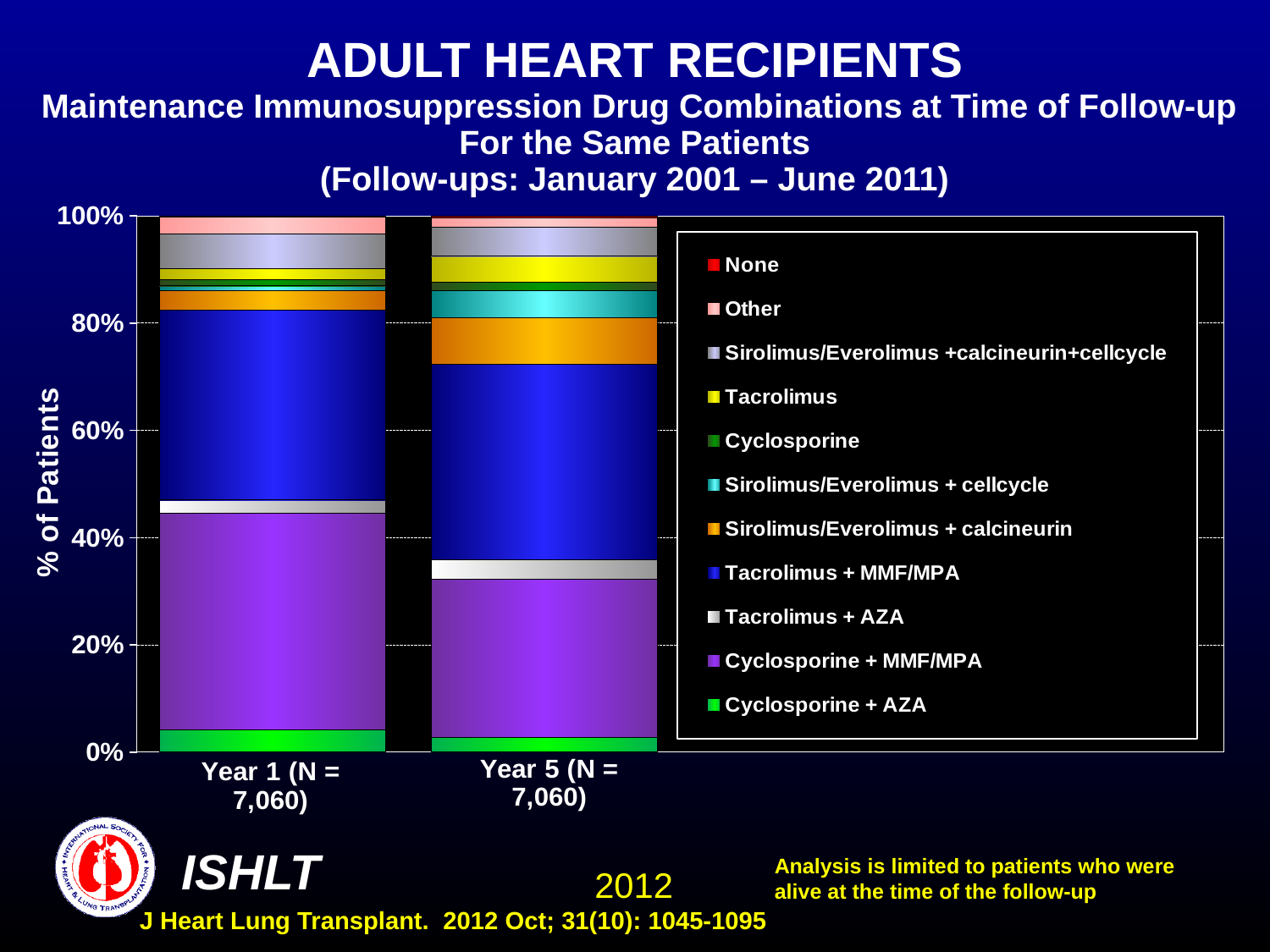
How many drug combination series does the legend list? 11 What is the label of the y axis? % of Patients How many bars (follow-up time points) are plotted in the chart? 2 Does the share of Tacrolimus alone rise or fall from Year 1 to Year 5? Rise What kind of chart is shown on the slide? Stacked bar chart Is the share of Tacrolimus + MMF/MPA in Year 1 greater or less than 20%? greater Which bar has the larger Sirolimus/Everolimus + calcineurin segment, Year 1 or Year 5? Year 5 What is the N shown for the Year 5 bar? 7,060 Which bar has the larger Cyclosporine + MMF/MPA segment, Year 1 or Year 5? Year 1 Is the share of Cyclosporine + MMF/MPA in Year 5 greater or less than 40%? less Does the share of Cyclosporine + MMF/MPA rise or fall from Year 1 to Year 5? Fall Which drug combination makes up the largest segment of the Year 5 bar? Tacrolimus + MMF/MPA